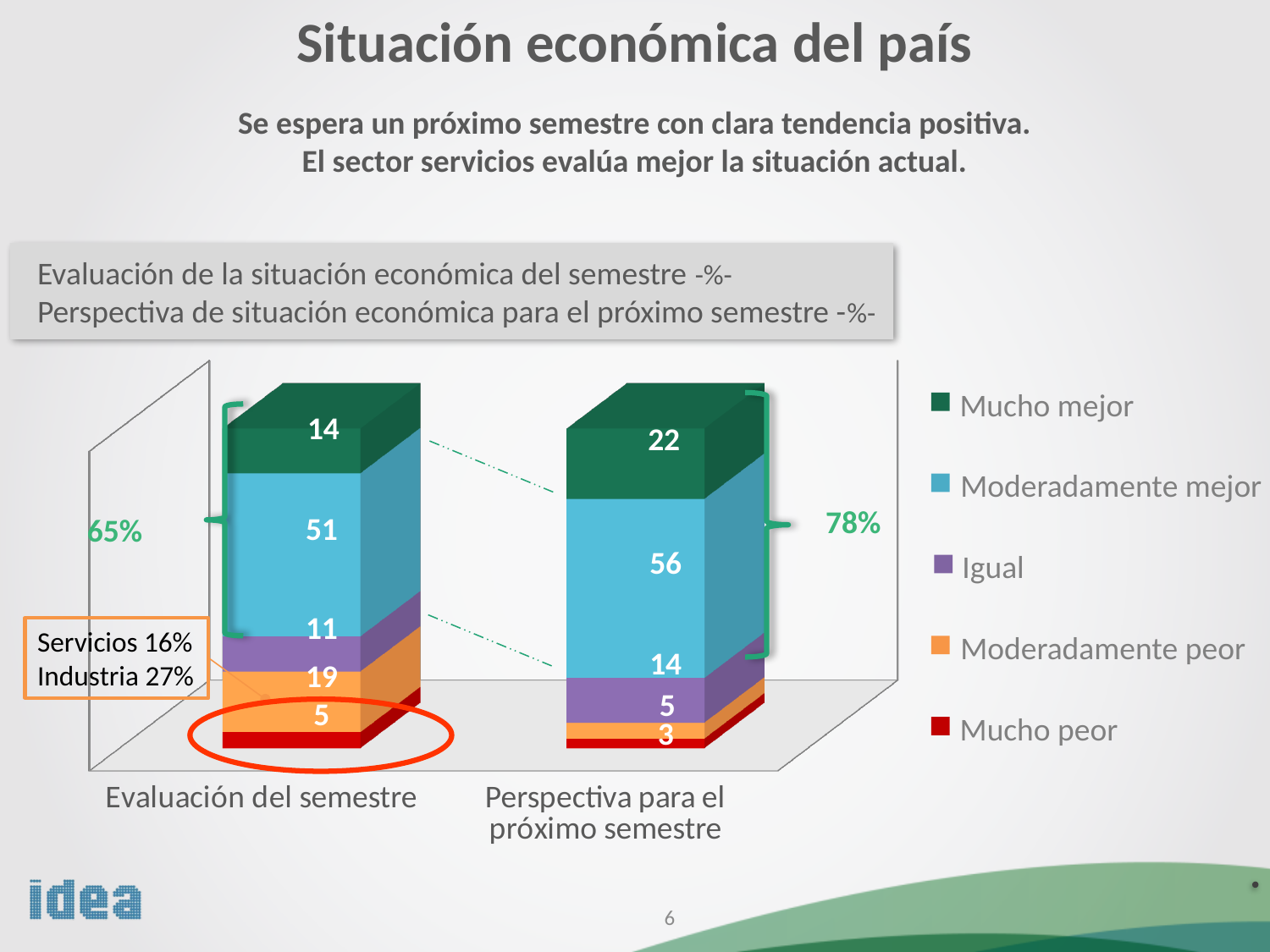
What is the value for 'Mucho peor' in 'Perspectiva para el próximo semestre'? 3 What is the value for 'Igual' in 'Evaluación del semestre'? 11 What is the total of the stacked bar for 'Evaluación del semestre'? 100 Which series has the highest value in 'Perspectiva para el próximo semestre'? Moderadamente mejor What kind of chart is shown on the slide? Stacked bar chart What is the value for 'Mucho mejor' in 'Evaluación del semestre'? 14 What is the value for 'Moderadamente mejor' in 'Perspectiva para el próximo semestre'? 56 How many series does the legend list? 5 What is the difference between the 'Mucho mejor' values for 'Perspectiva para el próximo semestre' and 'Evaluación del semestre'? 8 How many categories are shown on the x axis? 2 Which series has the lowest value in 'Evaluación del semestre'? Mucho peor Which is larger: 'Moderadamente peor' in 'Evaluación del semestre' or 'Moderadamente peor' in 'Perspectiva para el próximo semestre'? Evaluación del semestre